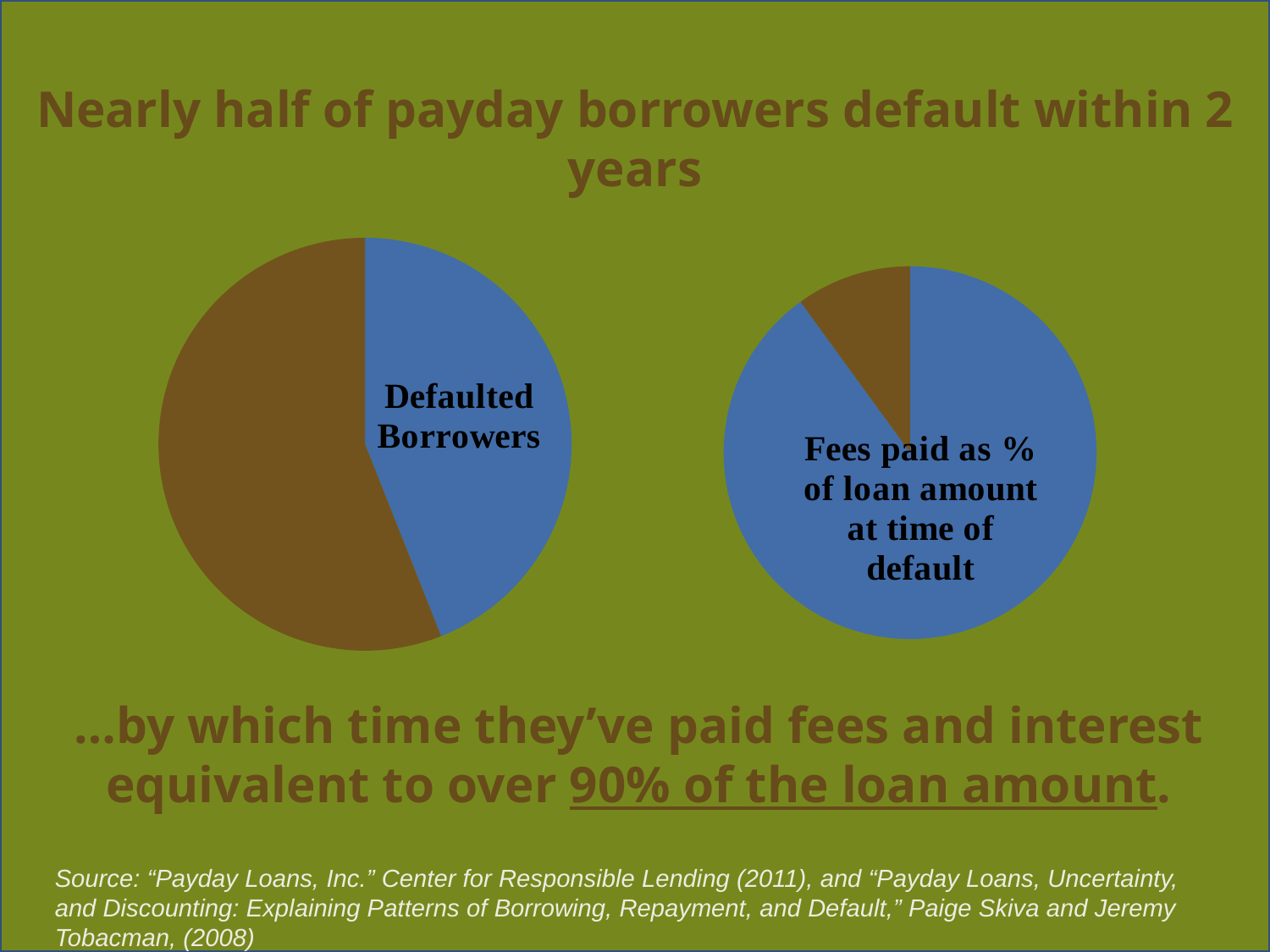
How many charts are shown on the slide? 2 In the right pie chart, how many slices are there? 2 In the right pie chart, is the blue slice more or less than half of the pie? more What kind of chart is the right chart on the slide? pie chart In the left pie chart, what label is printed on the blue slice? Defaulted Borrowers What kind of chart is the left chart on the slide? pie chart In the left pie chart, is the blue slice more or less than half of the pie? less In the left pie chart, which slice is larger, the blue slice or the brown slice? brown In the right pie chart, what label is printed on the blue slice? Fees paid as % of loan amount at time of default In the left pie chart, how many slices are there? 2